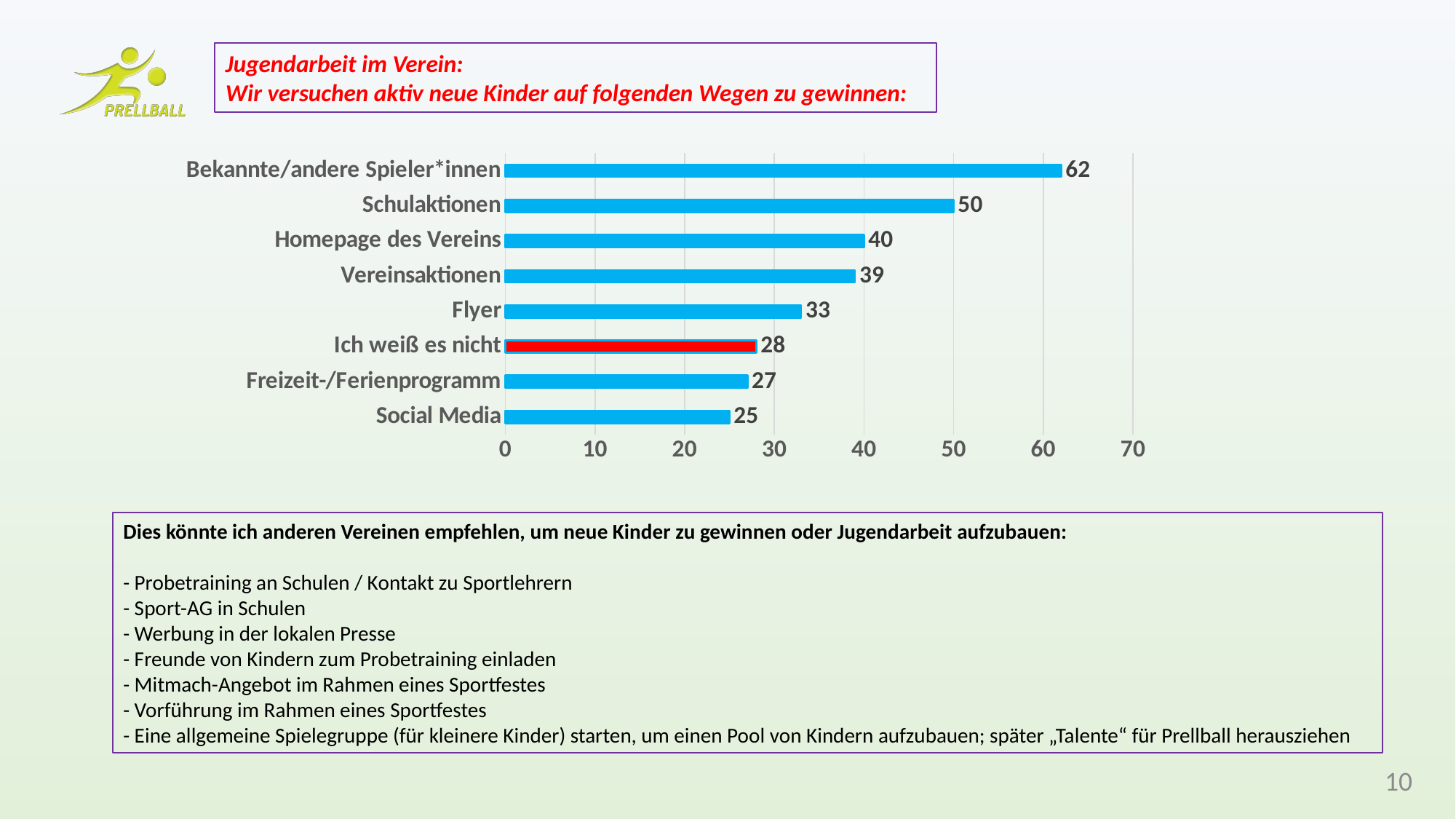
Which bar is coloured red instead of blue? Ich weiß es nicht Which category has the highest value? Bekannte/andere Spieler*innen What is the value for Schulaktionen? 50 How many categories are shown in the chart? 8 Is the value for Vereinsaktionen greater or less than 30? greater Which is larger, the value for Homepage des Vereins or the value for Flyer? Homepage des Vereins What is the highest value shown on the x axis? 70 What is the difference between the values for Bekannte/andere Spieler*innen and Schulaktionen? 12 Which category has the lowest value? Social Media What kind of chart is shown on the slide? bar chart What is the value for Social Media? 25 What is the value for Ich weiß es nicht? 28